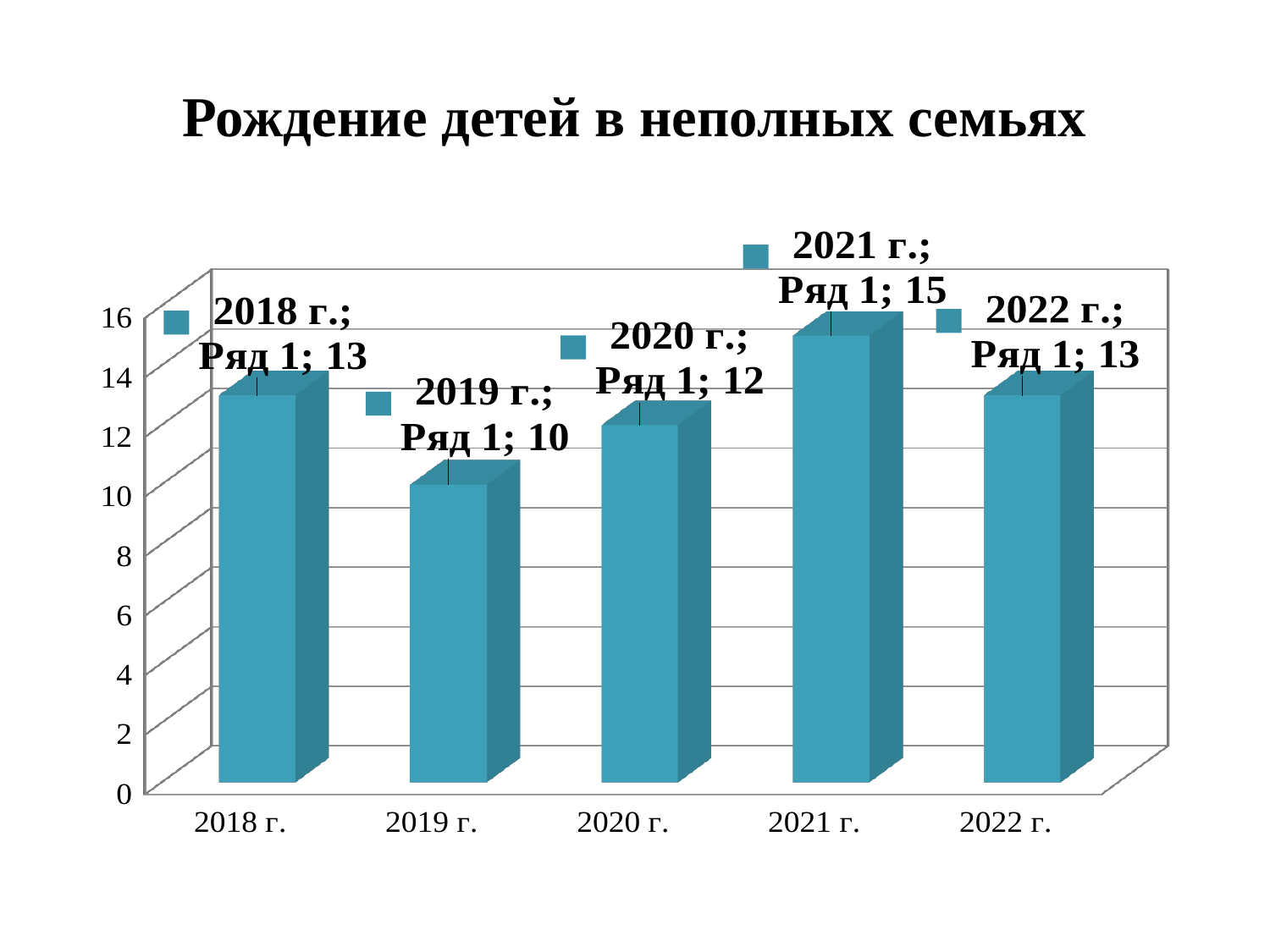
Does the value rise or fall from 2021 г. to 2022 г.? fall What is the value for 2019 г.? 10 How many years are shown on the x axis? 5 Which is larger, the value for 2020 г. or the value for 2022 г.? 2022 г. What is the value for 2021 г.? 15 What is the title of the chart? Рождение детей в неполных семьях Is the value for 2021 г. greater or less than 14? greater What is the value for 2018 г.? 13 Which year has the highest value? 2021 г. What is the difference between the values for 2021 г. and 2019 г.? 5 Which year has the lowest value? 2019 г. What kind of chart is shown on the slide? bar chart